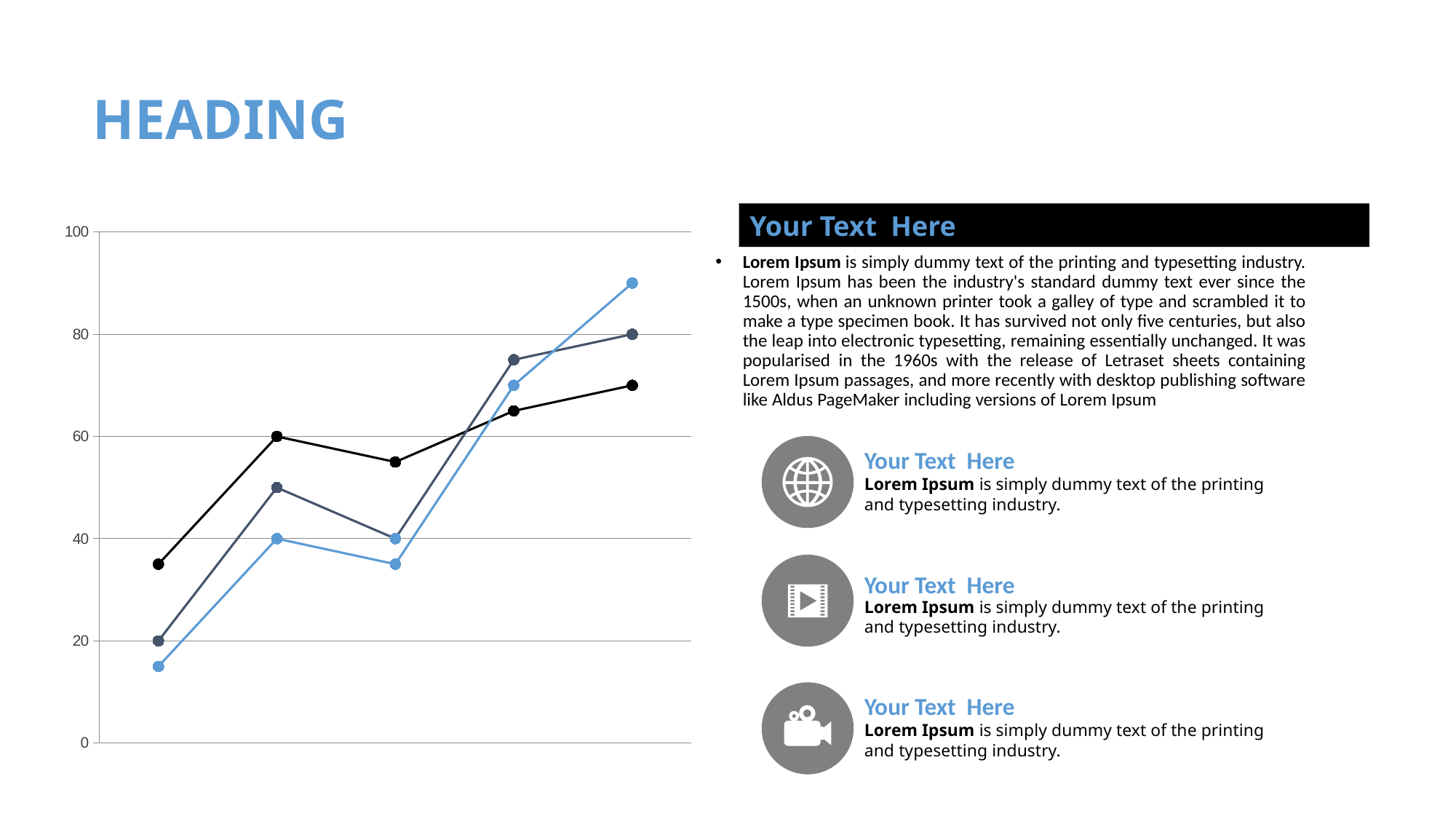
What is the value of the dark slate line at its last point? 80 How many data points does each line on the chart have? 5 What is the value of the dark slate line at its first point? 20 What kind of chart is shown on the slide? line chart Which line has the highest value at the last point on the x axis? the light blue line What is the value of the black line at its second point? 60 Is the value of the light blue line at its last point greater or less than 80? greater Is the value of the black line at its last point greater or less than 80? less How many lines are plotted on the chart? 3 Which line has the lowest value at the first point on the x axis? the light blue line Is the value of the light blue line at its first point greater or less than 20? less What is the value of the light blue line at its second point? 40